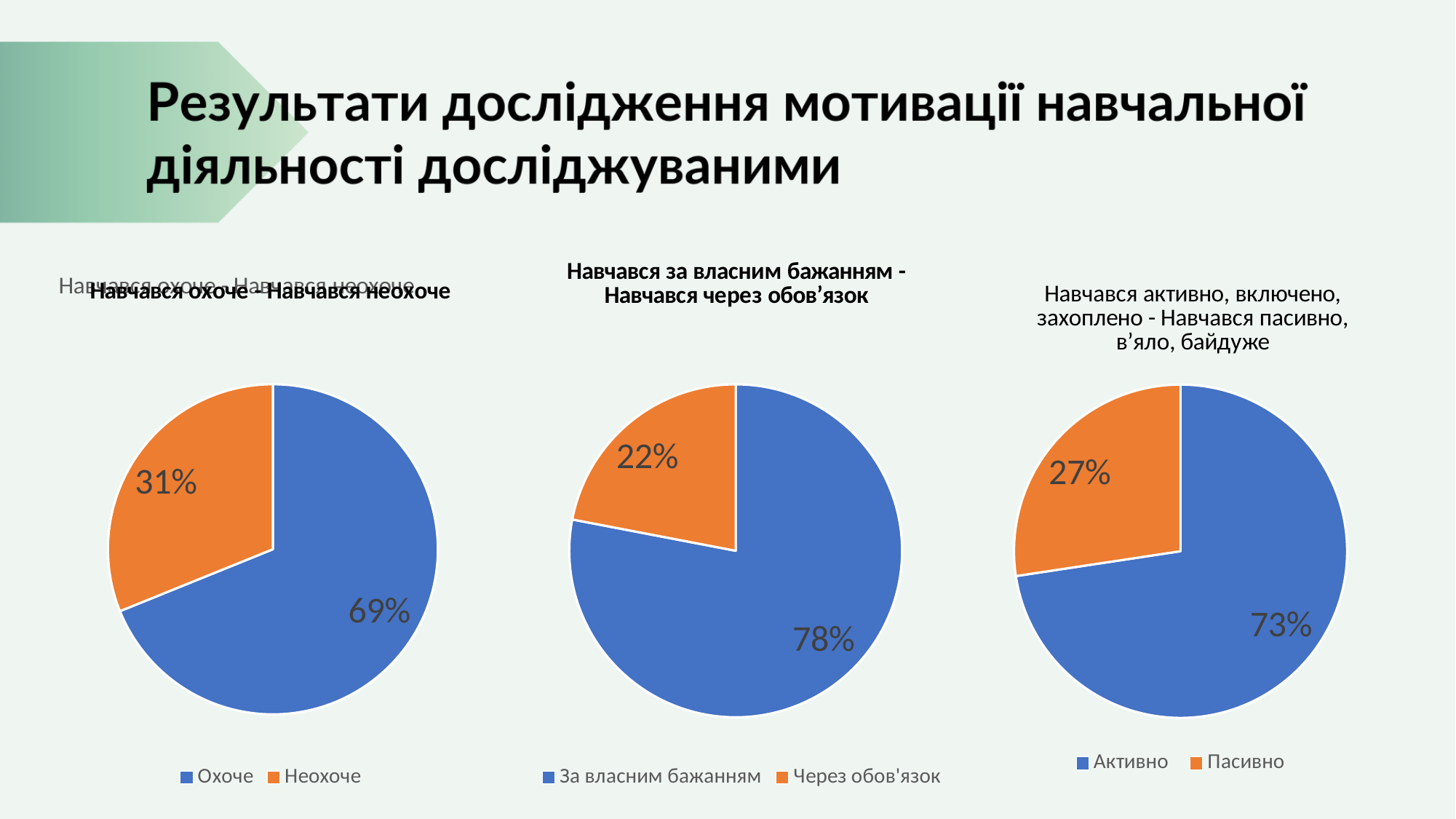
In the left pie chart, what share is labelled for Охоче? 69% In the right pie chart, what is the difference in percentage points between Активно and Пасивно? 46 In the left pie chart, what share is labelled for Неохоче? 31% In the right pie chart, what share is labelled for Активно? 73% How many entries does the legend of the middle pie chart list? 2 In the left pie chart, which is larger, Охоче or Неохоче? Охоче In the right pie chart, what share is labelled for Пасивно? 27% In the middle pie chart, what share is labelled for Через обов'язок? 22% In the left pie chart, which slice is the largest? Охоче How many charts are on the slide, and what type are they? 3 pie charts In the middle pie chart, which slice is the smallest? Через обов'язок In the middle pie chart, what share is labelled for За власним бажанням? 78%